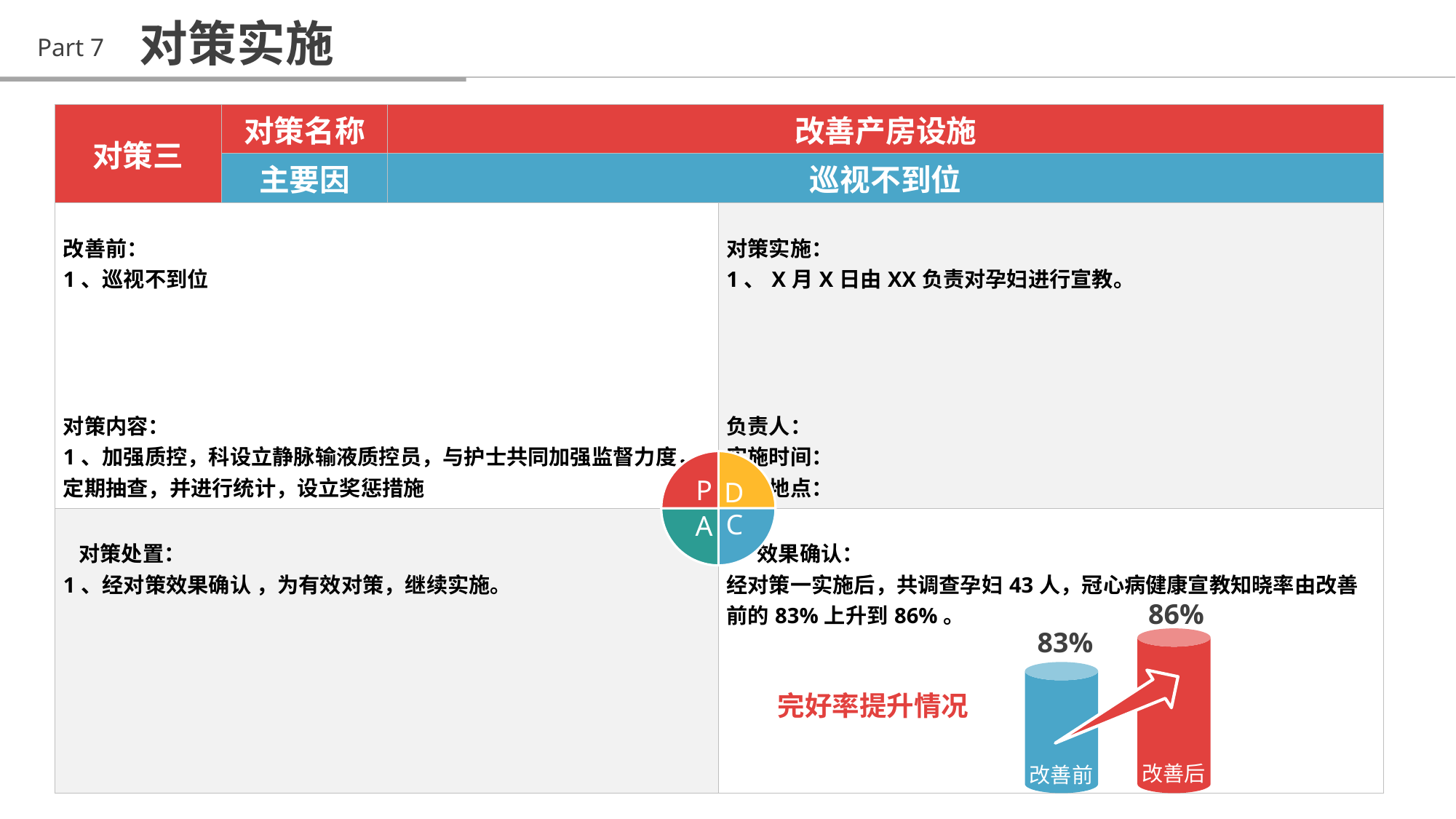
What is the title text next to the chart? 完好率提升情况 Which category has the higher value in the chart, 改善前 or 改善后? 改善后 Which category has the highest value in the chart? 改善后 How many categories are shown in the chart? 2 Do the values rise or fall from 改善前 to 改善后 in the chart? rise What is the value shown for 改善后 in the chart? 86% What colour is the 改善后 bar in the chart? red What is the value shown for 改善前 in the chart? 83% Which category has the lowest value in the chart? 改善前 What kind of chart is shown on the slide? bar chart What is the difference between the 改善后 value and the 改善前 value in the chart? 3%